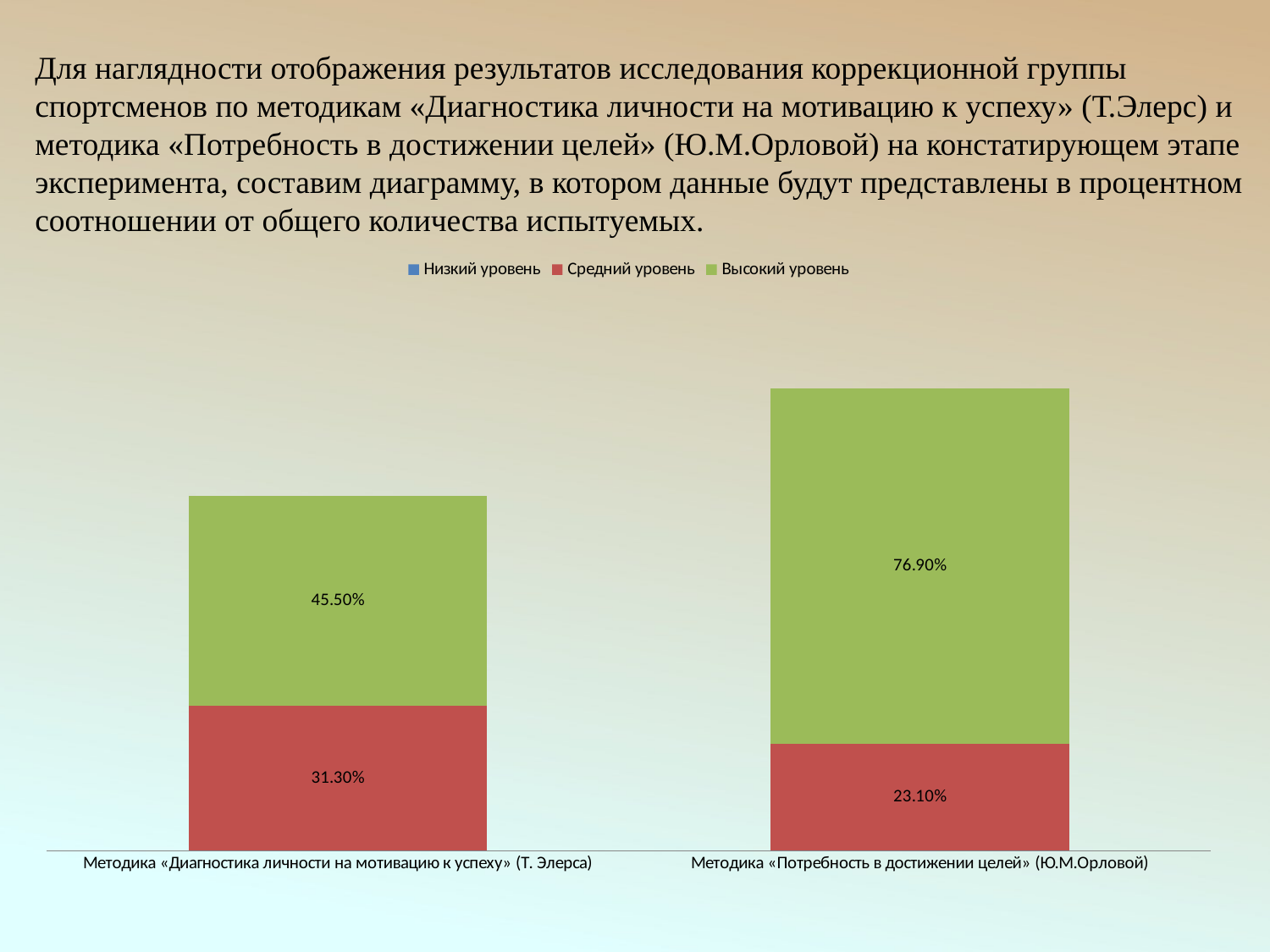
Which method has the lower value for Средний уровень? Методика «Потребность в достижении целей» (Ю.М.Орловой) What is the value of Средний уровень for Методика «Потребность в достижении целей» (Ю.М.Орловой)? 23.10% What is the difference between Высокий уровень and Средний уровень for Методика «Потребность в достижении целей» (Ю.М.Орловой)? 53.80% How many categories (methods) are shown on the x axis? 2 What is the value of Высокий уровень for Методика «Диагностика личности на мотивацию к успеху» (Т. Элерса)? 45.50% Which method has the higher value for Высокий уровень? Методика «Потребность в достижении целей» (Ю.М.Орловой) Which legend entry is shown in green? Высокий уровень What is the value of Средний уровень for Методика «Диагностика личности на мотивацию к успеху» (Т. Элерса)? 31.30% How many series does the legend list? 3 What is the value of Высокий уровень for Методика «Потребность в достижении целей» (Ю.М.Орловой)? 76.90% What is the difference between the Высокий уровень values of the two methods? 31.40% What kind of chart is shown on the slide? Stacked bar chart